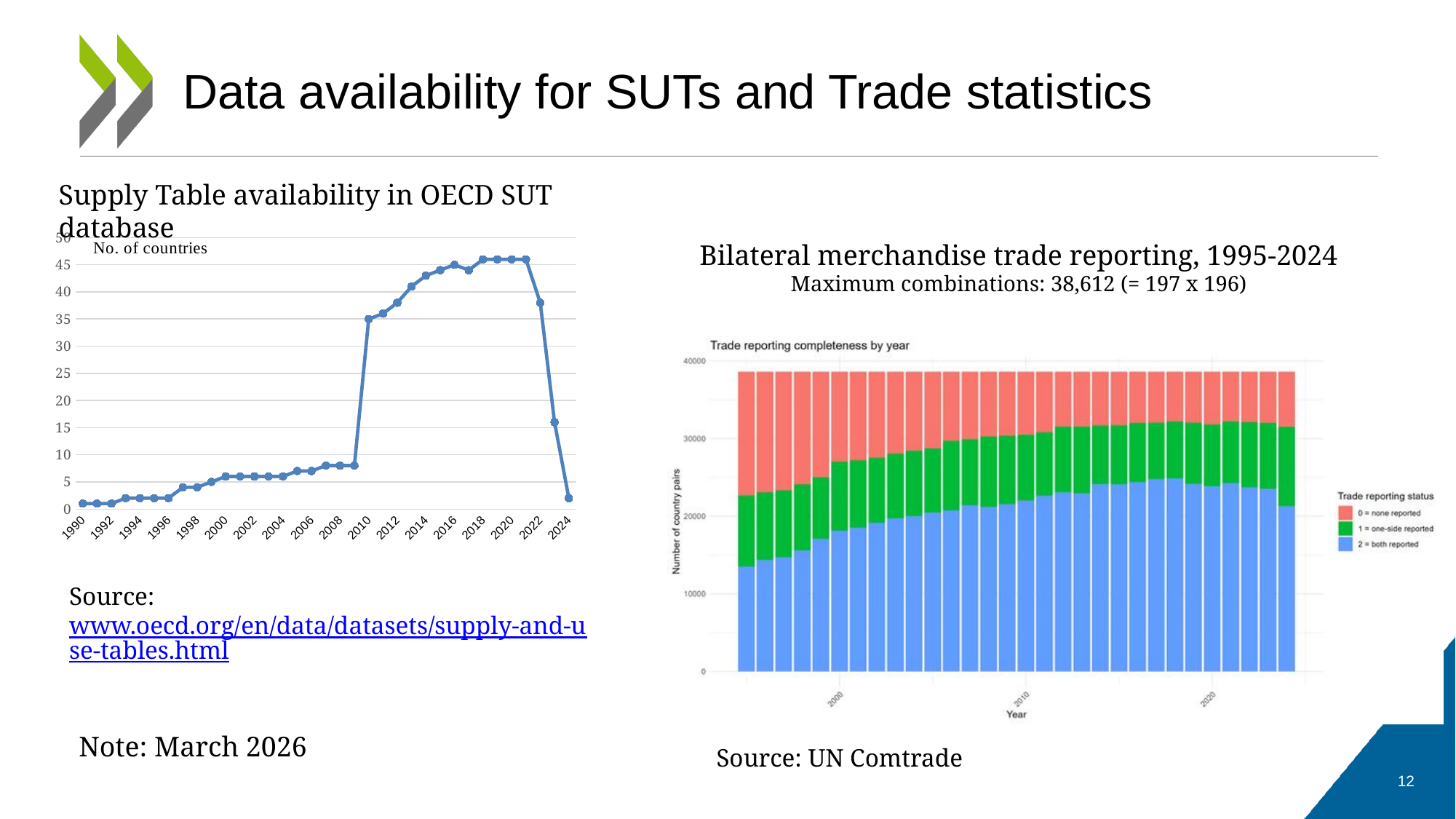
In the 'Trade reporting completeness by year' chart, which colour represents '0 = none reported' in the legend? red In the 'Trade reporting completeness by year' chart, what is the label of the y axis? Number of country pairs In the 'Trade reporting completeness by year' chart, is the '2 = both reported' value for the first bar (1995) greater or less than 20000? less In the 'Supply Table availability in OECD SUT database' chart, is the value for 1990 greater or less than 5? less In the 'Supply Table availability in OECD SUT database' chart, is the value for 2022 greater or less than 30? greater What kind of chart is the 'Trade reporting completeness by year' chart on the right? bar chart In the 'Trade reporting completeness by year' chart, how many series does the legend list? 3 In the 'Supply Table availability in OECD SUT database' chart, do the values rise or fall between 2010 and 2018? rise What kind of chart is the 'Supply Table availability in OECD SUT database' chart on the left? line chart In the 'Supply Table availability in OECD SUT database' chart, which is larger, the value for 2010 or the value for 2008? 2010